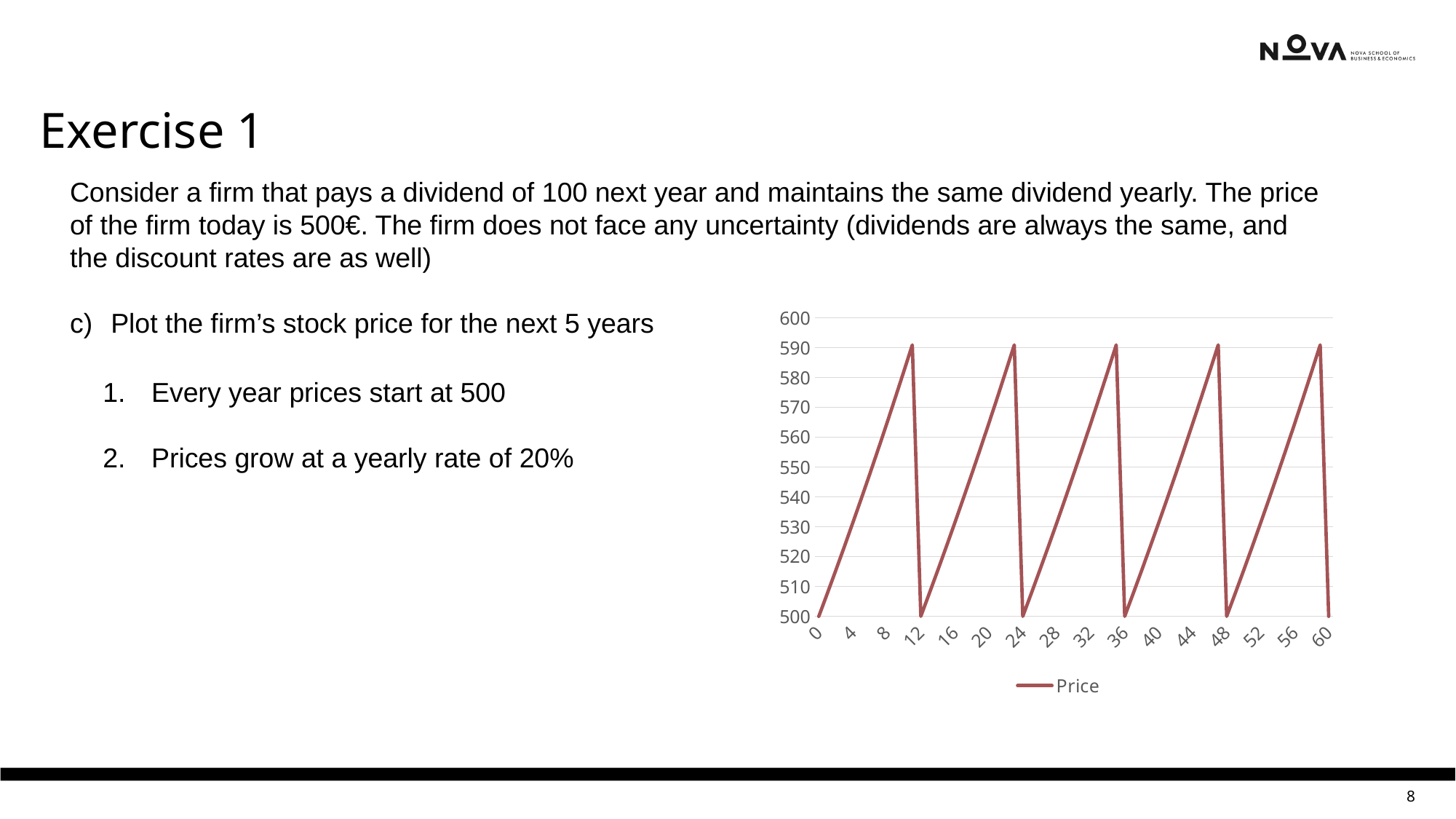
What is the name of the series shown in the chart legend? Price Is the value of Price at x = 8 greater or less than 550? greater How many series does the chart legend list? 1 Is the peak value of Price just before x = 12 greater or less than 580? greater What kind of chart is shown on the slide? line chart What is the value of Price at x = 0? 500 What is the value of Price at x = 60? 500 What is the highest value labelled on the y axis? 600 How many tick labels are shown on the x axis? 16 Is the value of Price at x = 4 greater or less than 550? less How many peaks does the Price line have across the chart? 5